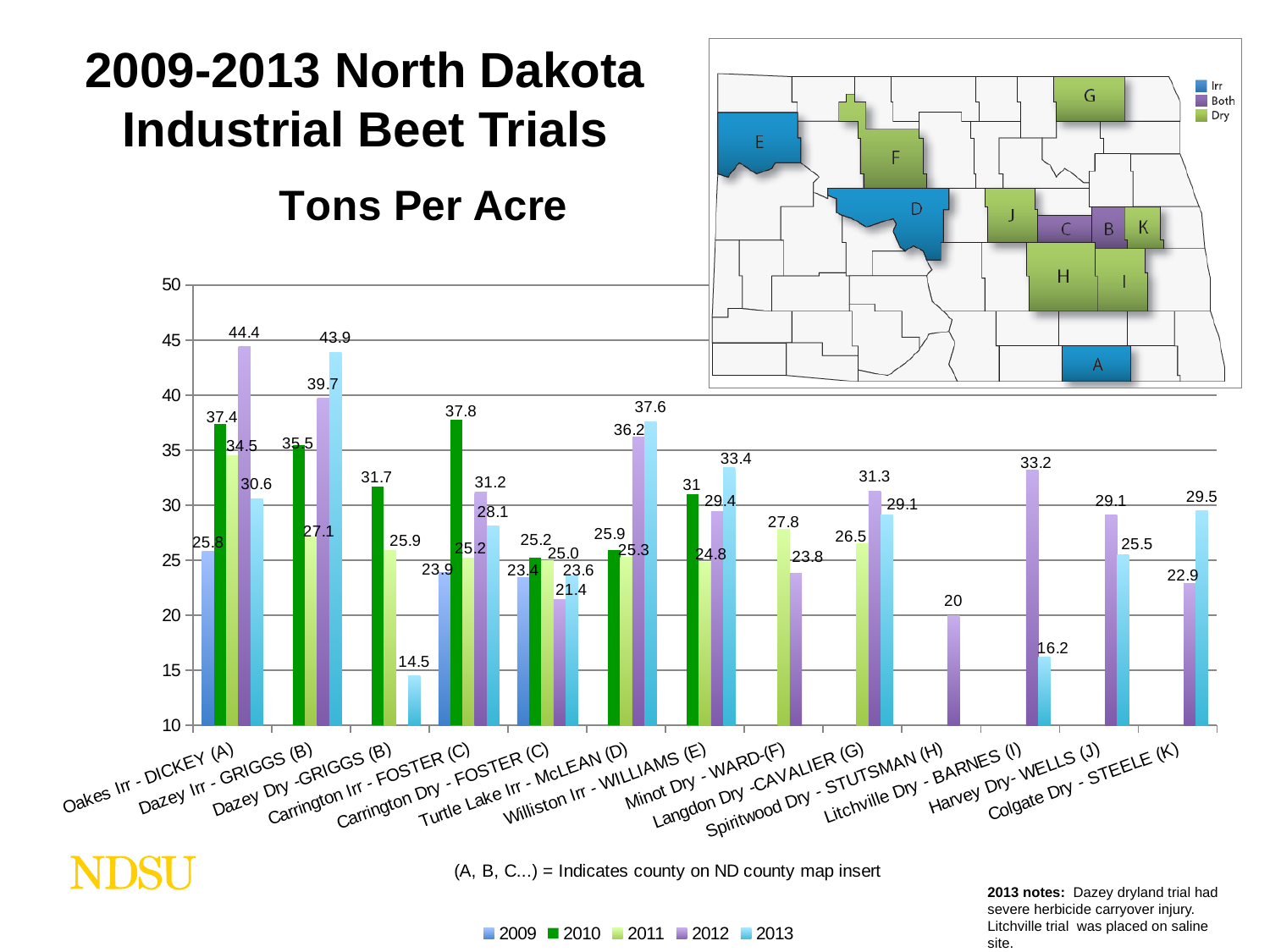
What type of chart is used to show tons per acre? Bar chart What was the 2010 value for Carrington Irr - FOSTER (C)? 37.8 What was the 2013 value for Dazey Dry - GRIGGS (B)? 14.5 What is the difference between the 2013 values for Dazey Irr - GRIGGS (B) and Dazey Dry - GRIGGS (B)? 29.4 Which is larger: the 2013 value for Turtle Lake Irr - McLEAN (D) or the 2013 value for Williston Irr - WILLIAMS (E)? Turtle Lake Irr - McLEAN (D) How many locations are shown on the x axis of the chart? 13 How many years does the chart legend list? 5 What was the 2012 value for Oakes Irr - DICKEY (A)? 44.4 What was the 2012 value for Spiritwood Dry - STUTSMAN (H)? 20 Did the value for Litchville Dry - BARNES (I) rise or fall from 2012 to 2013? Fall Which location and year has the lowest tons per acre on the chart? Dazey Dry - GRIGGS (B), 2013 Which location and year has the highest tons per acre on the chart? Oakes Irr - DICKEY (A), 2012